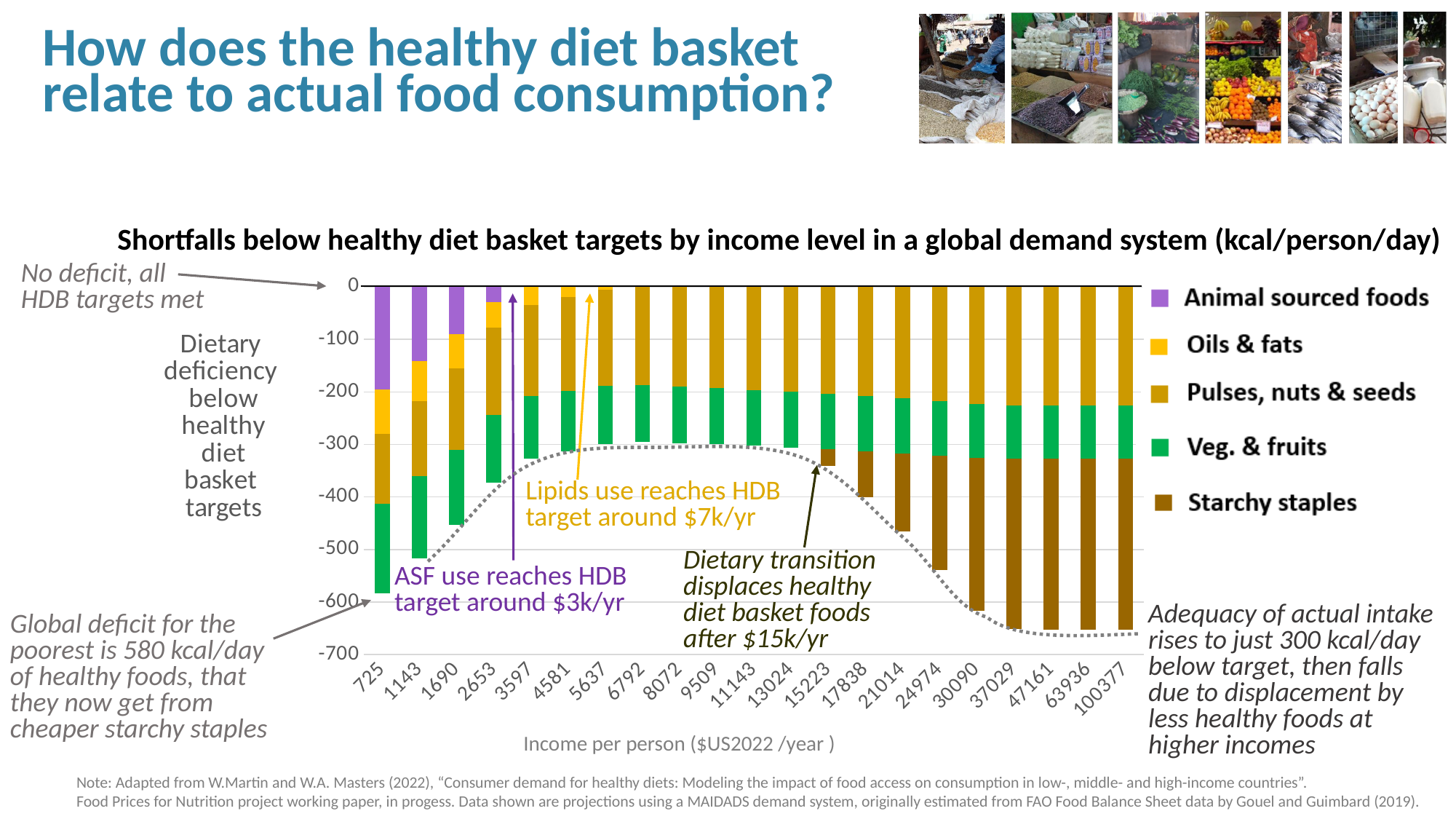
How many income levels (bars) are plotted along the x axis? 21 How many bars include an Animal sourced foods segment? 4 Moving from income level 725 to 9509, does the total deficit shown by the stacked bars shrink or grow? shrink What is the title of the chart? Shortfalls below healthy diet basket targets by income level in a global demand system (kcal/person/day) Does the stacked bar for income level 9509 extend below the -400 tick on the axis? no How many series does the legend list? 5 Which income level has the larger total deficit (bar extending further below zero), 725 or 9509? 725 According to the annotation on the chart, what is the global deficit of healthy foods for the poorest? 580 kcal/day Does the stacked bar for income level 725 extend below the -500 tick on the axis? yes How many bars include a Starchy staples segment? 9 What kind of chart is shown on the slide? Stacked bar chart Moving from income level 15223 to 47161, does the bottom of the stacked bars move further below zero or closer to zero? further below zero